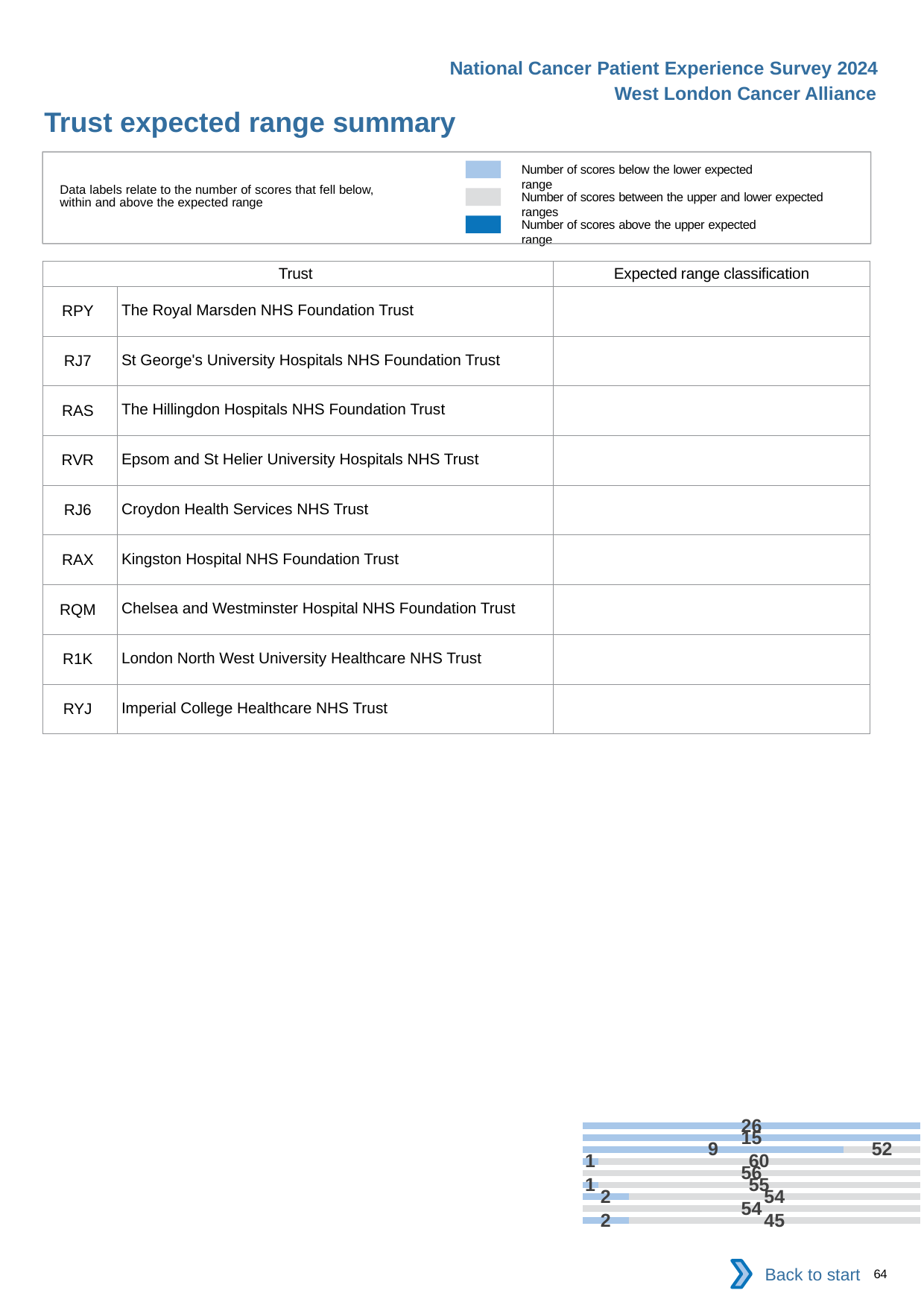
What is the smallest data label printed on the chart? 1 What is the largest data label printed on the chart? 60 According to the legend, what does the dark blue colour represent? Number of scores above the upper expected range What kind of chart is shown at the bottom right of the slide? bar chart How many series does the legend list for the expected range chart? 3 According to the legend, what does the light blue colour represent? Number of scores below the lower expected range